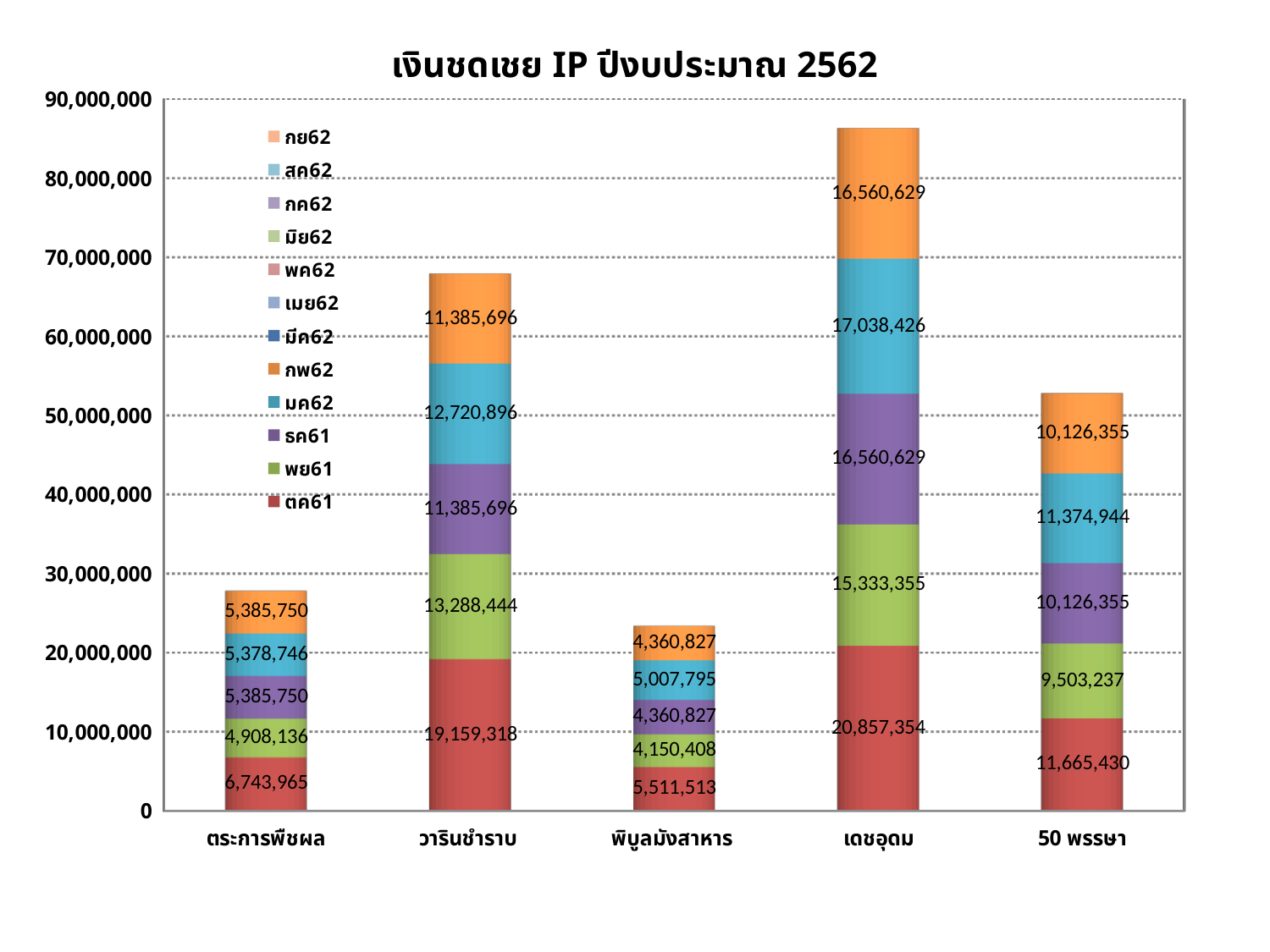
What is the value of มค62 for 50 พรรษา? 11,374,944 Which category has the tallest stacked bar? เดชอุดม What is the value of พย61 for วารินชำราบ? 13,288,444 What is the difference between the ตค61 values for วารินชำราบ and ตระการพืชผล? 12,415,353 What kind of chart is shown on the slide? stacked bar chart Which is larger, the กพ62 value for 50 พรรษา or the กพ62 value for พิบูลมังสาหาร? 50 พรรษา What is the title of the chart? เงินชดเชย IP ปีงบประมาณ 2562 What is the total of the stacked bar for พิบูลมังสาหาร? 23,391,370 How many categories are shown on the x axis? 5 What is the value of ตค61 for เดชอุดม? 20,857,354 How many series does the legend list? 12 Which category has the shortest stacked bar? พิบูลมังสาหาร